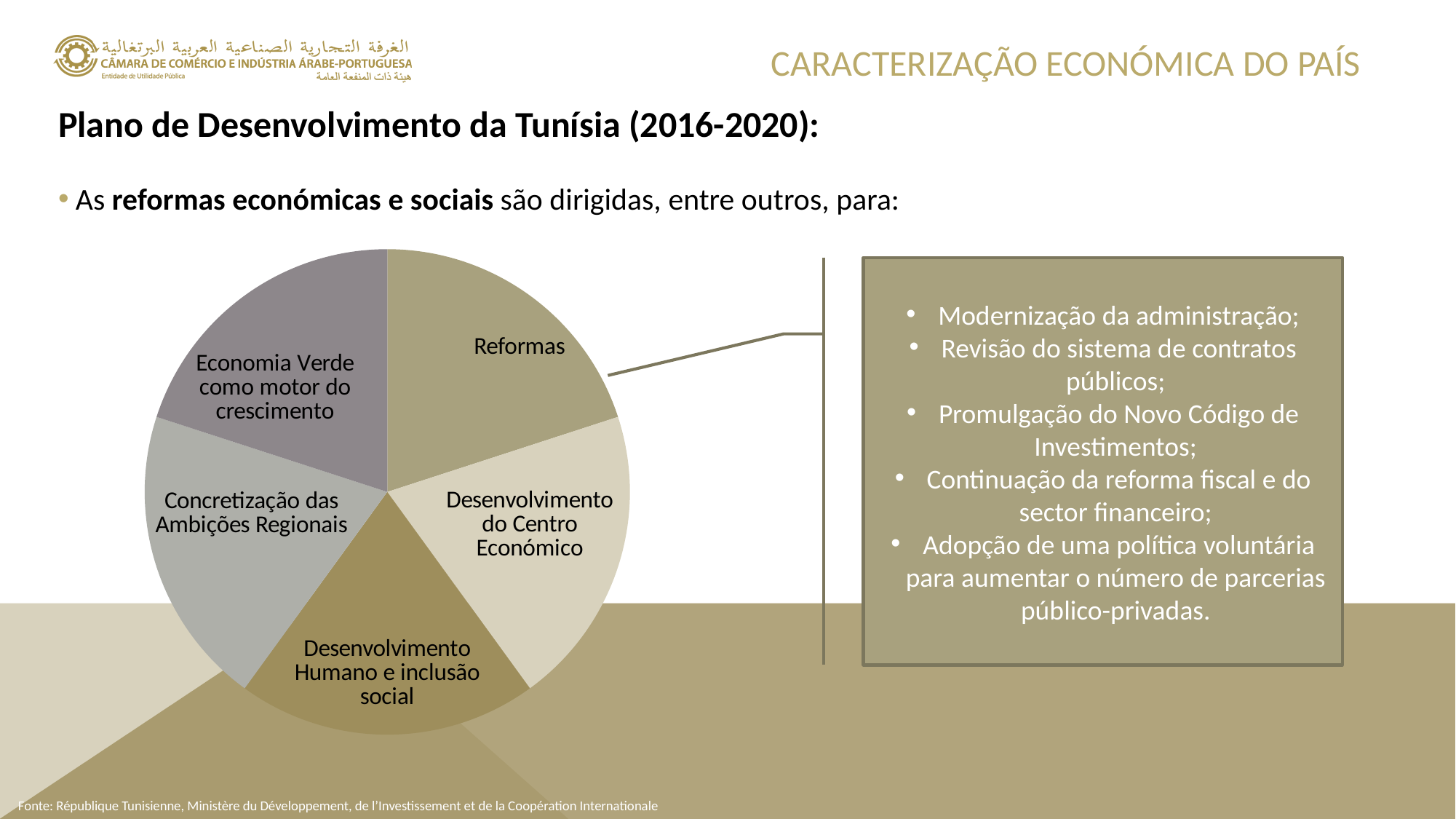
What is the label of the slice at the bottom of the pie chart? Desenvolvimento Humano e inclusão social What is the label of the slice on the left side of the pie chart, below 'Economia Verde como motor do crescimento'? Concretização das Ambições Regionais What is the label of the slice at the top right of the pie chart? Reformas Which slice of the pie chart is labelled with the words 'Economia Verde'? Economia Verde como motor do crescimento Do the slices of the pie chart appear to be of equal size? Yes How many slices does the pie chart have? 5 Which slice of the pie chart is connected by a line to the text box on the right? Reformas What kind of chart is shown on the slide? Pie chart What is the label of the slice on the right side of the pie chart, below 'Reformas'? Desenvolvimento do Centro Económico